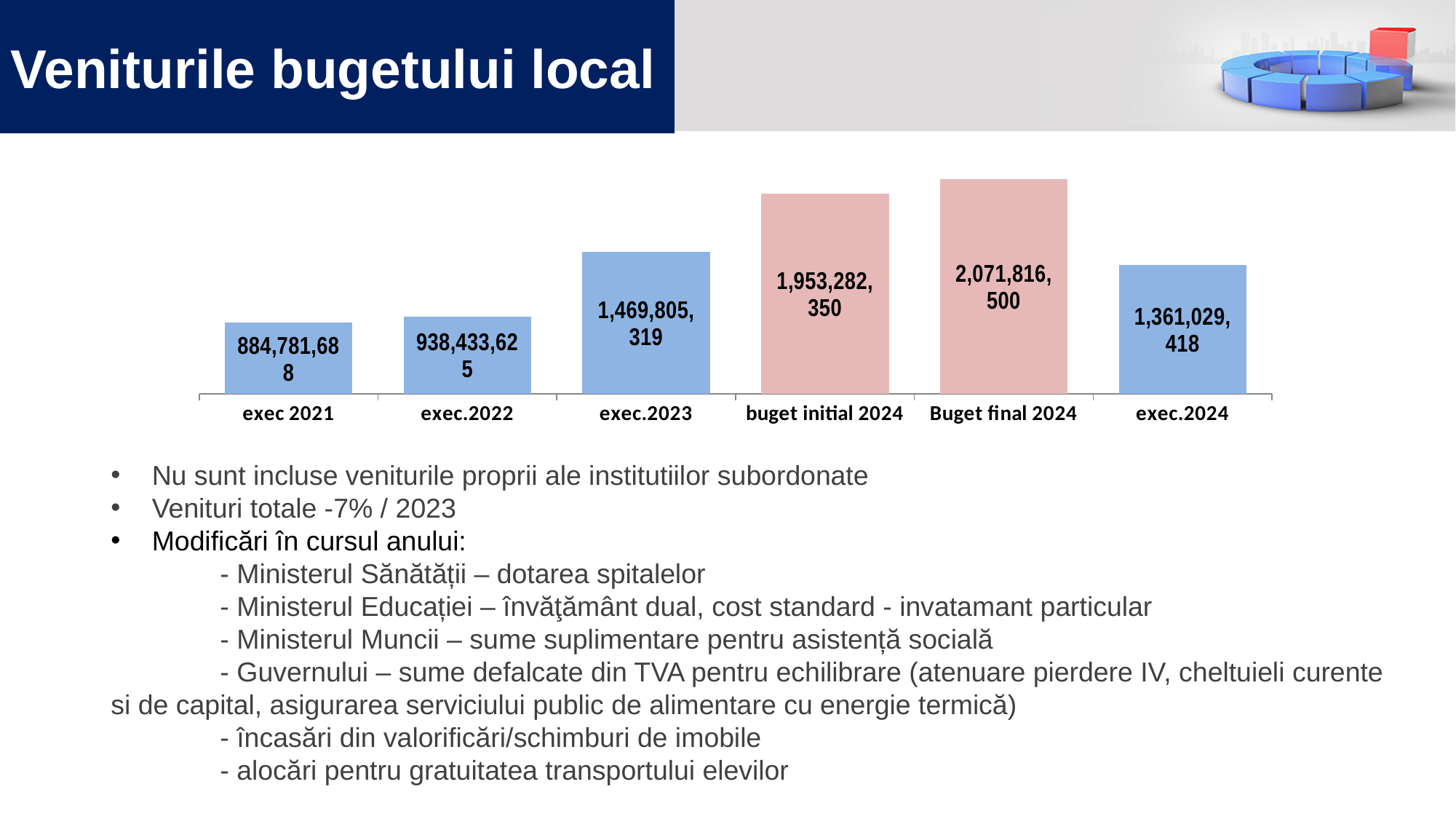
What is the value for Buget final 2024? 2,071,816,500 How many categories are shown in the chart? 6 What is the value for exec 2021? 884,781,688 What is the difference between exec.2023 and exec.2024? 108,775,901 Which category has the lowest value? exec 2021 Which category has the highest value? Buget final 2024 What is the difference between Buget final 2024 and buget initial 2024? 118,534,150 What is the value for exec.2024? 1,361,029,418 What is the value for exec.2023? 1,469,805,319 Which is larger, exec.2023 or exec.2024? exec.2023 What colour are the bars for buget initial 2024 and Buget final 2024? pink What kind of chart is shown on the slide? bar chart